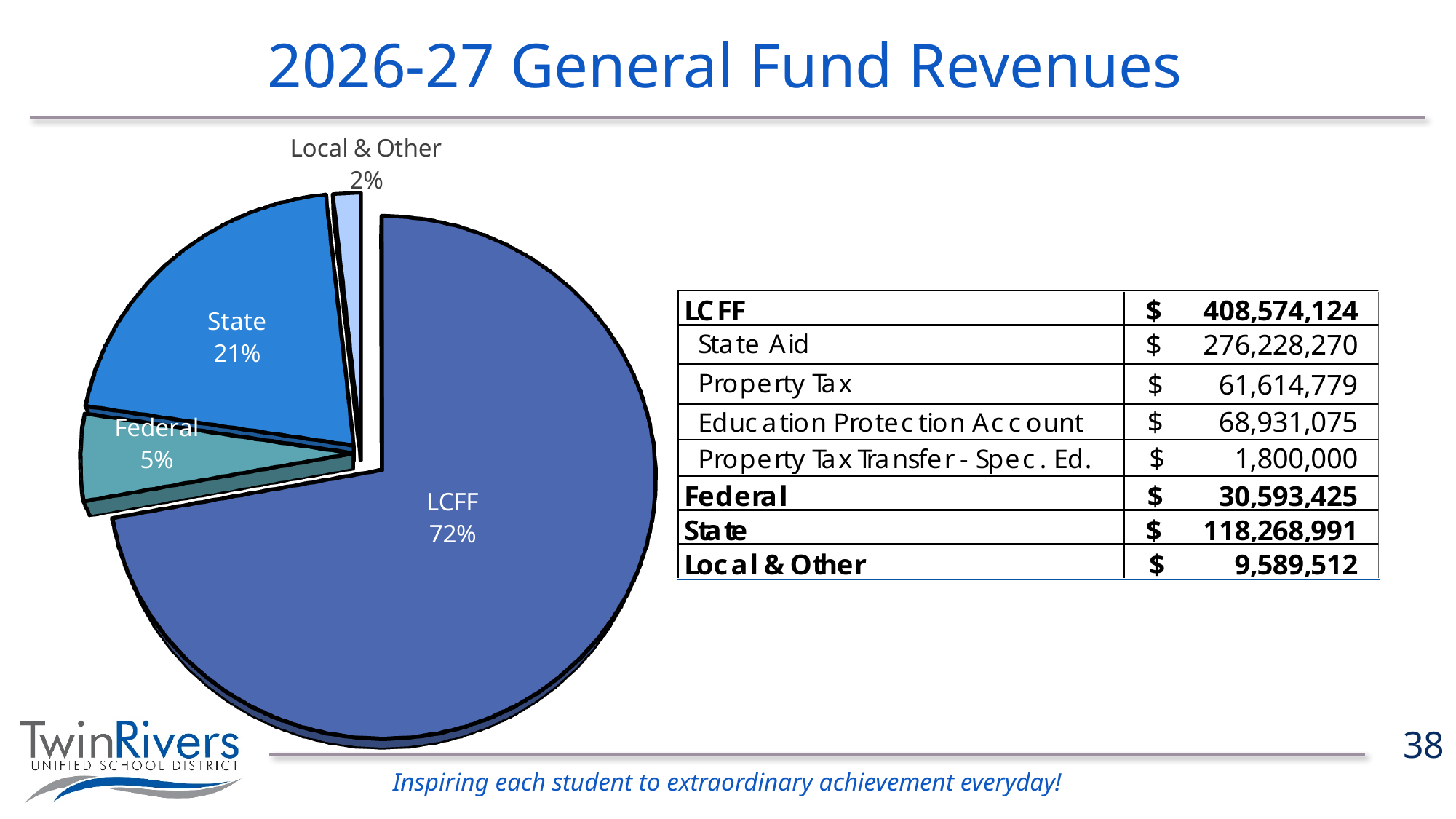
Which slice of the pie is shown in the darkest blue colour? LCFF What share of the pie does Federal represent? 5% What share of the pie does Local & Other represent? 2% Which slice of the pie is the largest? LCFF Which is larger, the State slice or the Federal slice? State What share of the pie does LCFF represent? 72% What kind of chart is shown on the slide? Pie chart How many slices does the pie chart have? 4 What is the title of the slide containing the pie chart? 2026-27 General Fund Revenues Which slice of the pie is the smallest? Local & Other What is the difference in percentage points between the LCFF slice and the State slice? 51 percentage points